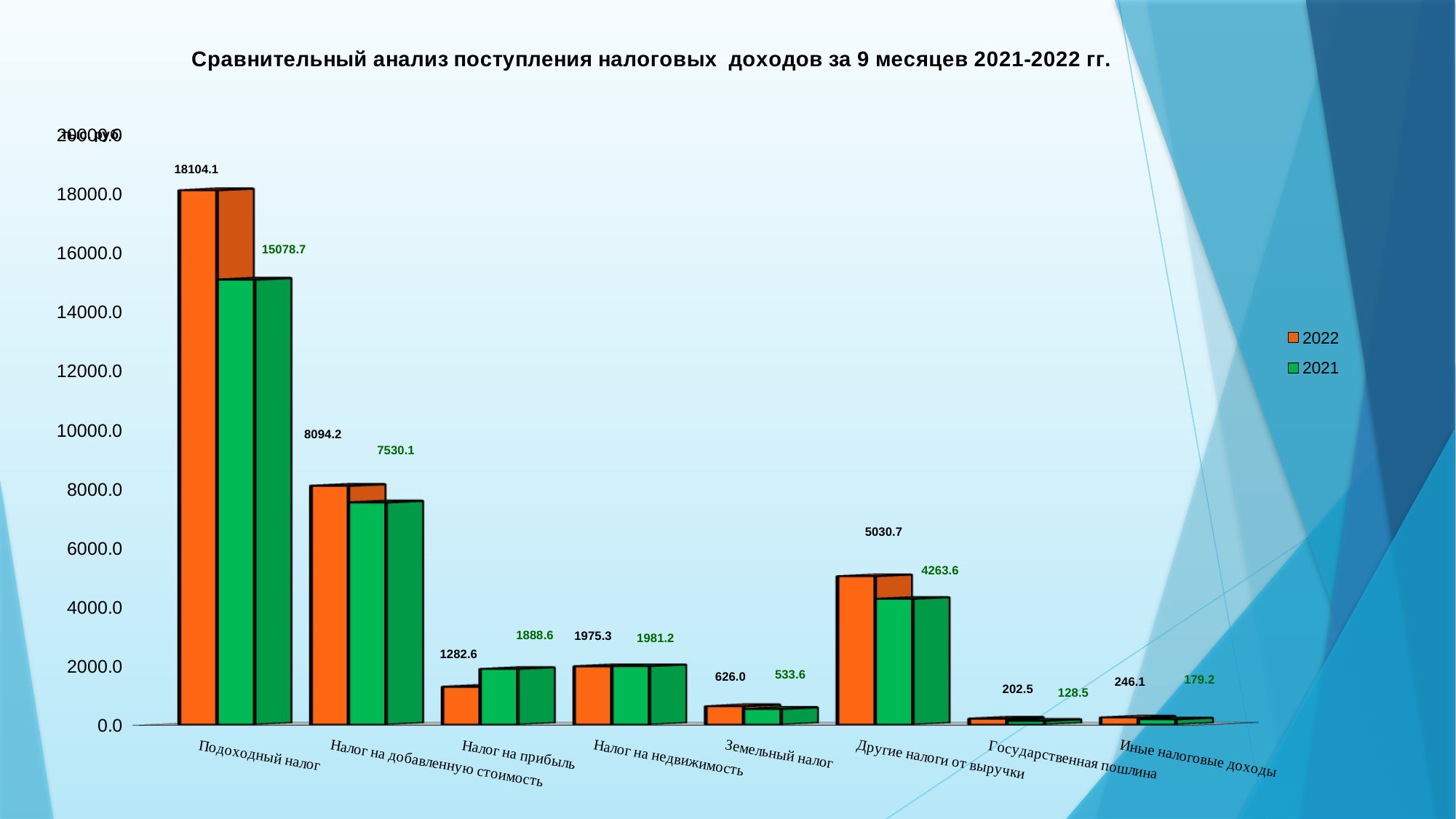
How many series does the legend list? 2 For Налог на прибыль, which series has the larger value, 2022 or 2021? 2021 Which category has the lowest value in the 2021 series? Государственная пошлина What is the difference between the 2021 and 2022 values for Налог на прибыль? 606.0 What is the value for Подоходный налог in the 2022 series? 18104.1 How many categories are shown on the x axis? 8 Is the 2022 value for Другие налоги от выручки greater or less than 4000? greater What is the value for Земельный налог in the 2022 series? 626.0 Which category has the highest value in the 2022 series? Подоходный налог What is the difference between the 2022 and 2021 values for Подоходный налог? 3025.4 What is the value for Государственная пошлина in the 2021 series? 128.5 What is the value for Налог на добавленную стоимость in the 2021 series? 7530.1